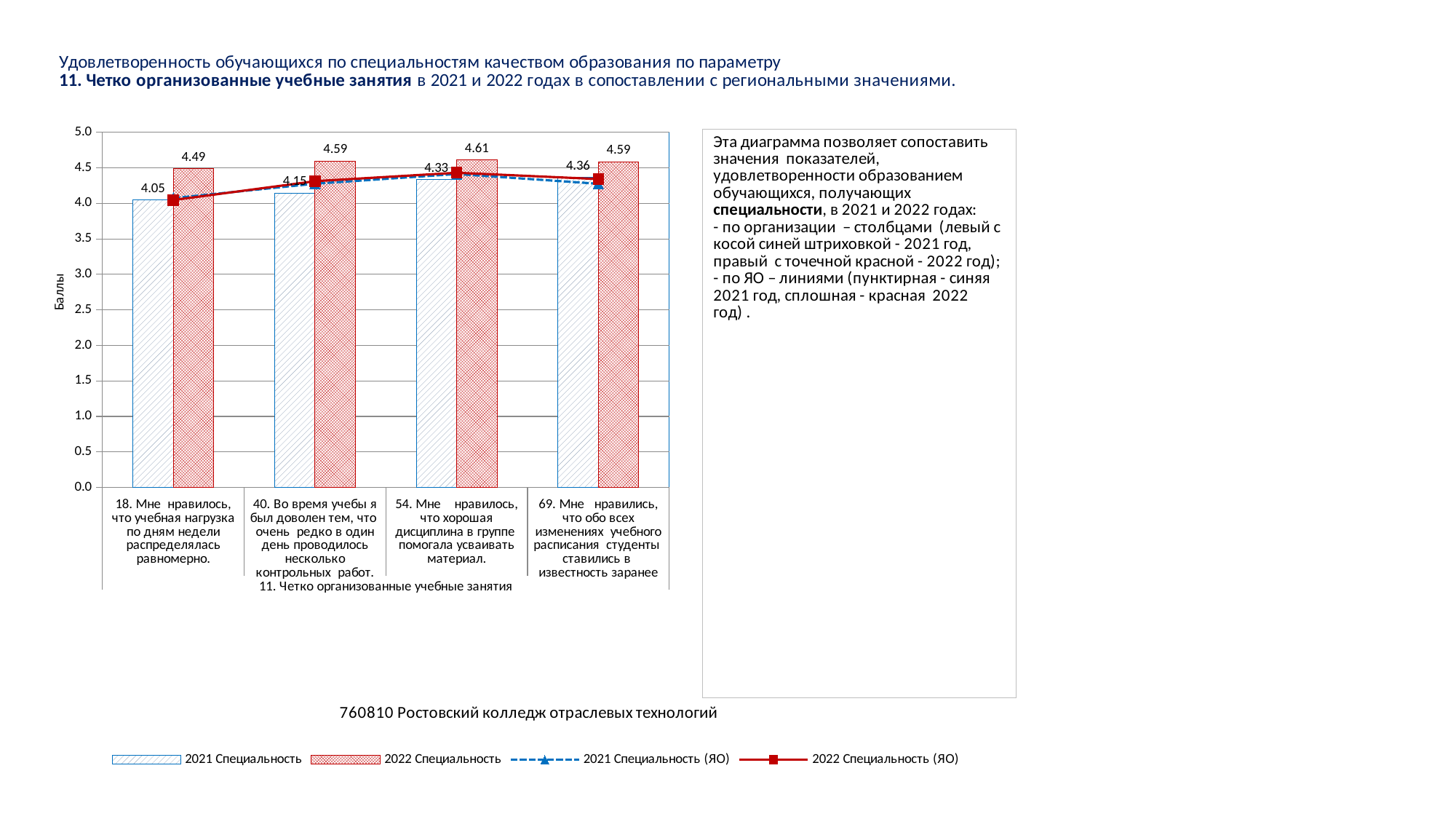
Do the 2022 Специальность bars rise or fall from item 18 to item 54? rise How many items (categories) are shown on the x axis? 4 What is the 2022 Специальность value for item 18 (Мне нравилось, что учебная нагрузка по дням недели распределялась равномерно)? 4.49 What kind of chart is shown on the slide? combination bar and line chart How many series does the legend list? 4 Is the 2021 Специальность (ЯО) line value for item 69 greater or less than 4.5? less Which item has the highest 2022 Специальность bar? 54. Мне нравилось, что хорошая дисциплина в группе помогала усваивать материал. Which item has the lowest 2021 Специальность bar? 18. Мне нравилось, что учебная нагрузка по дням недели распределялась равномерно. For item 18, how much higher is the 2022 Специальность value than the 2021 Специальность value? 0.44 What is the title of the vertical axis? Баллы What is the 2021 Специальность value for item 54 (Мне нравилось, что хорошая дисциплина в группе помогала усваивать материал)? 4.33 For item 40, which is larger: the 2021 Специальность bar or the 2022 Специальность bar? 2022 Специальность